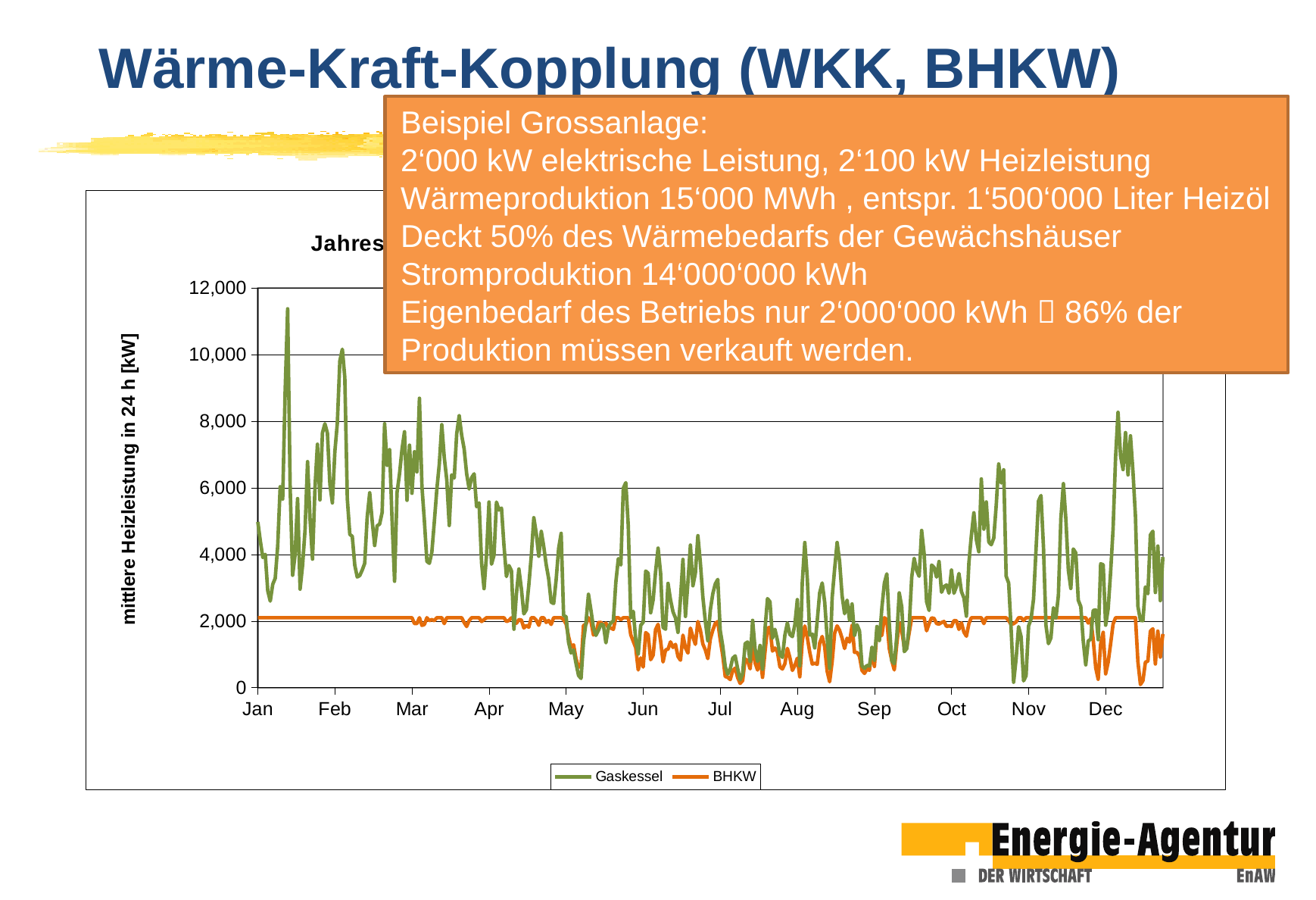
Is the highest value of the BHKW series greater or less than 4,000? less Is the BHKW value in January greater or less than 4,000? less What is the label of the chart's vertical axis? mittlere Heizleistung in 24 h [kW] Does the Gaskessel series generally rise or fall from July to December? rise What are the two series named in the chart legend? Gaskessel and BHKW How many series does the chart legend list? 2 Is the peak value of the Gaskessel series greater or less than 10,000? greater Does the Gaskessel series generally rise or fall from January to July? fall How many month labels are shown along the x axis of the chart? 12 In January, which series has the higher value, Gaskessel or BHKW? Gaskessel What kind of chart is shown on the slide? line chart Which series reaches the highest value in the chart, Gaskessel or BHKW? Gaskessel